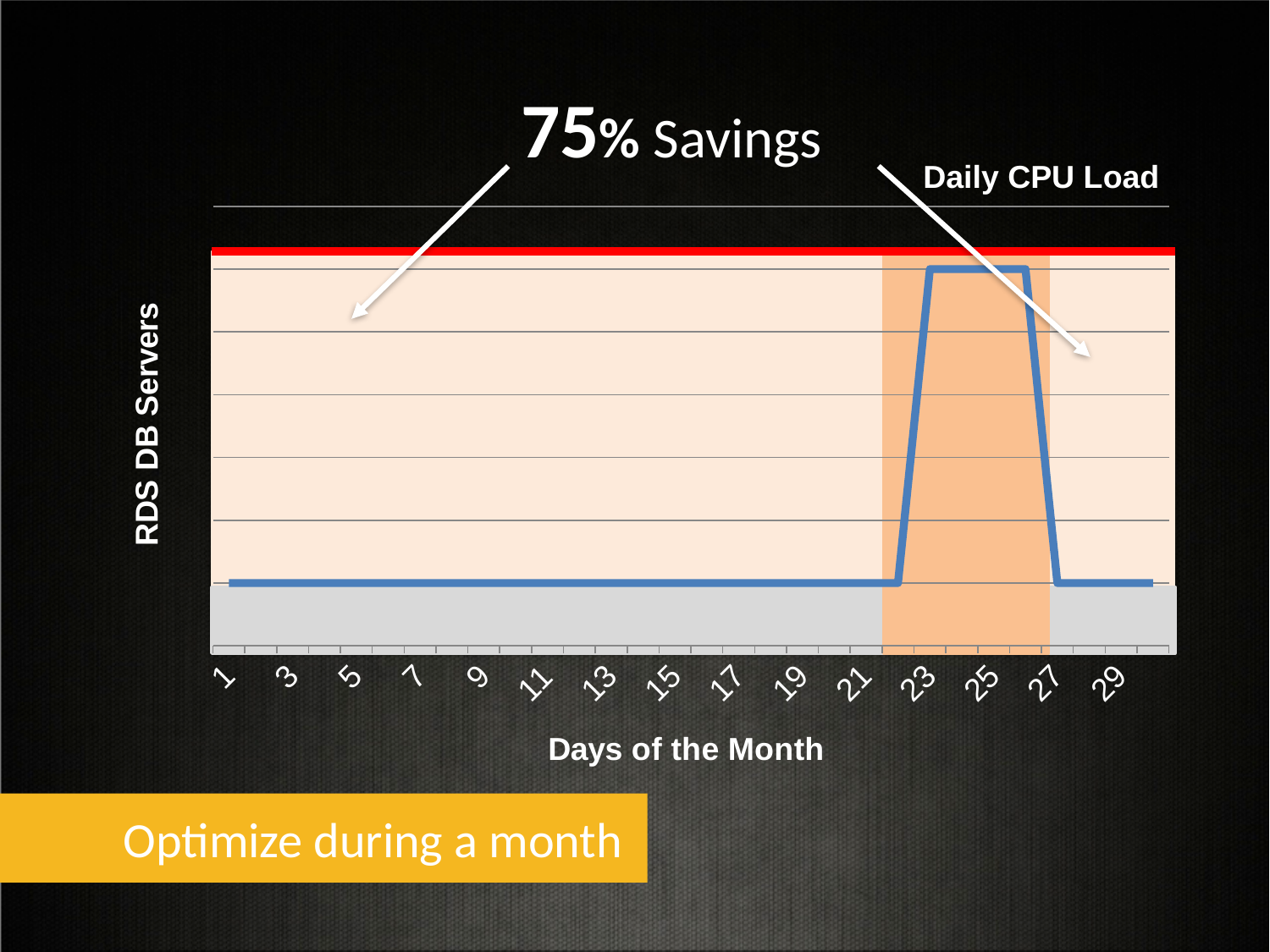
How many day labels are printed along the x axis of the chart? 15 What is the title of the y axis of the chart? RDS DB Servers What is the title of the x axis of the chart? Days of the Month From day 1 to day 21, does the blue line rise, fall, or stay flat? Stay flat What is the last day label shown on the x axis of the chart? 29 What savings percentage is annotated above the chart? 75% Is the value of the blue line on day 29 higher or lower than on day 25? Lower Between day 22 and day 23, does the blue line rise or fall? Rise Is the value of the blue line on day 24 higher or lower than on day 10? Higher Between day 26 and day 27, does the blue line rise or fall? Fall What is the first day label shown on the x axis of the chart? 1 What kind of chart is shown on the slide? Line chart